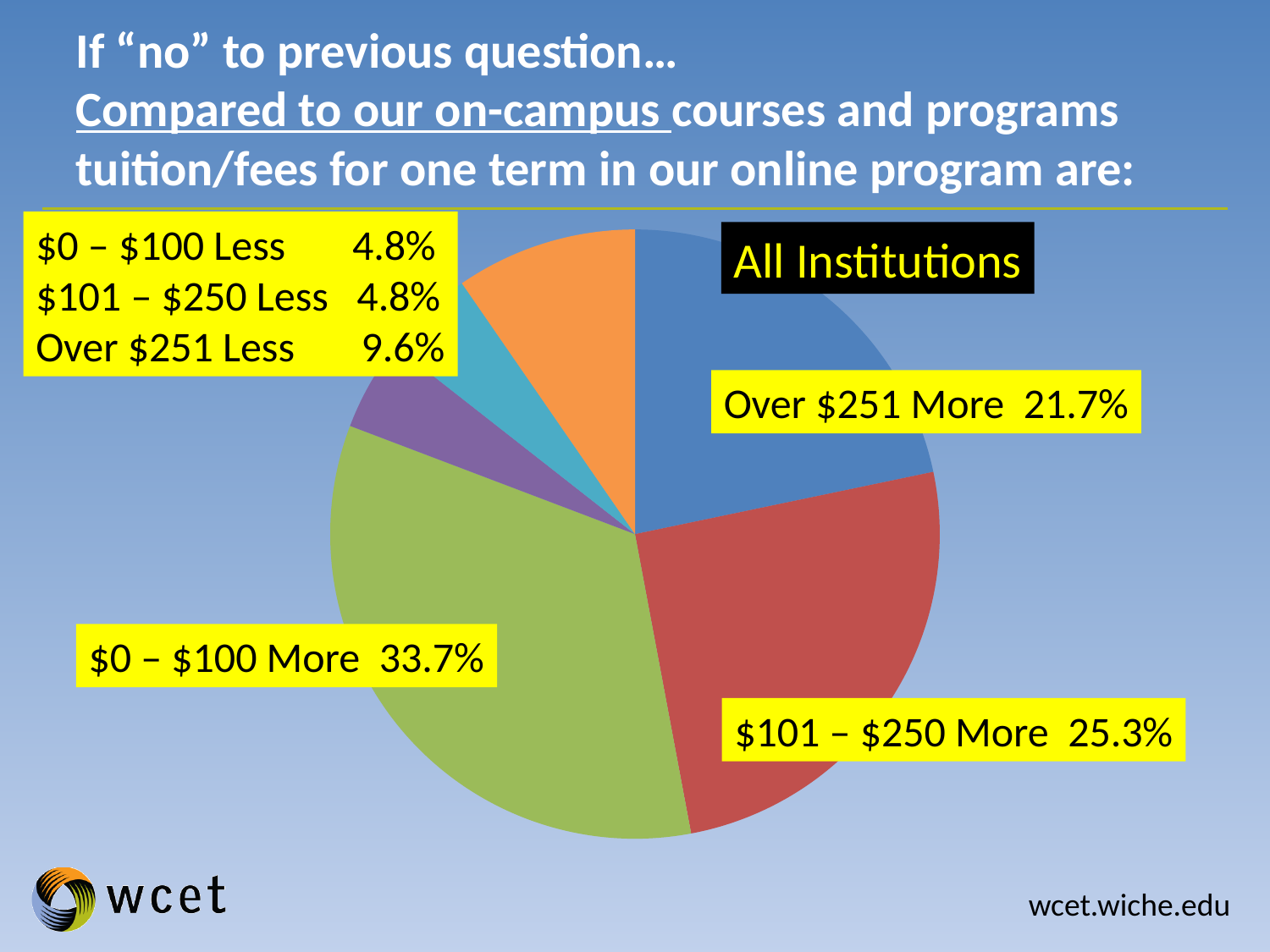
What kind of chart is shown on the slide? pie chart What is the title shown on the chart? All Institutions What is the difference between the shares for Over $251 Less and $0 – $100 Less? 4.8% Which is larger, the share for Over $251 More or the share for Over $251 Less? Over $251 More What colour is the slice for $0 – $100 More? green What percentage of institutions reported online tuition/fees are $101 – $250 More? 25.3% What percentage of institutions reported online tuition/fees are $0 – $100 More? 33.7% What is the difference between the shares for $0 – $100 More and $101 – $250 More? 8.4% Which category has the largest share of the pie? $0 – $100 More How many slices does the pie chart have? 6 What percentage of institutions reported online tuition/fees are Over $251 Less? 9.6% What percentage of institutions reported online tuition/fees are Over $251 More? 21.7%